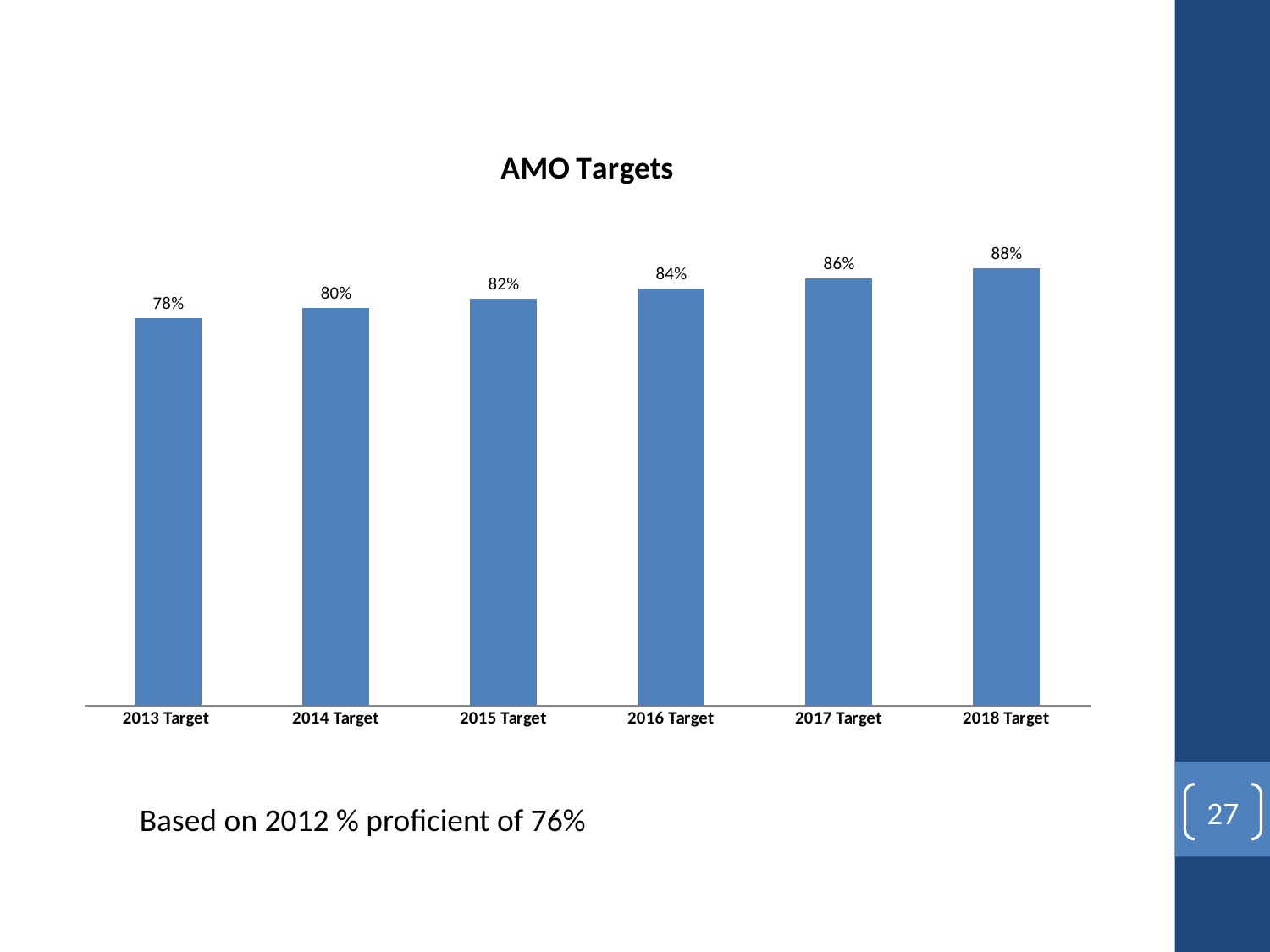
What kind of chart is shown on the slide? Bar chart What is the value for 2016 Target? 84% What is the difference between the 2018 Target and the 2013 Target values? 10% Which category has the lowest value? 2013 Target What is the difference between the 2015 Target and the 2014 Target values? 2% What is the value for 2018 Target? 88% Which category has the highest value? 2018 Target What is the title of the chart? AMO Targets What is the value for 2013 Target? 78% How many categories are shown on the x axis? 6 Which is larger, the value for 2017 Target or the value for 2015 Target? 2017 Target Do the values rise or fall from 2013 Target to 2018 Target? Rise